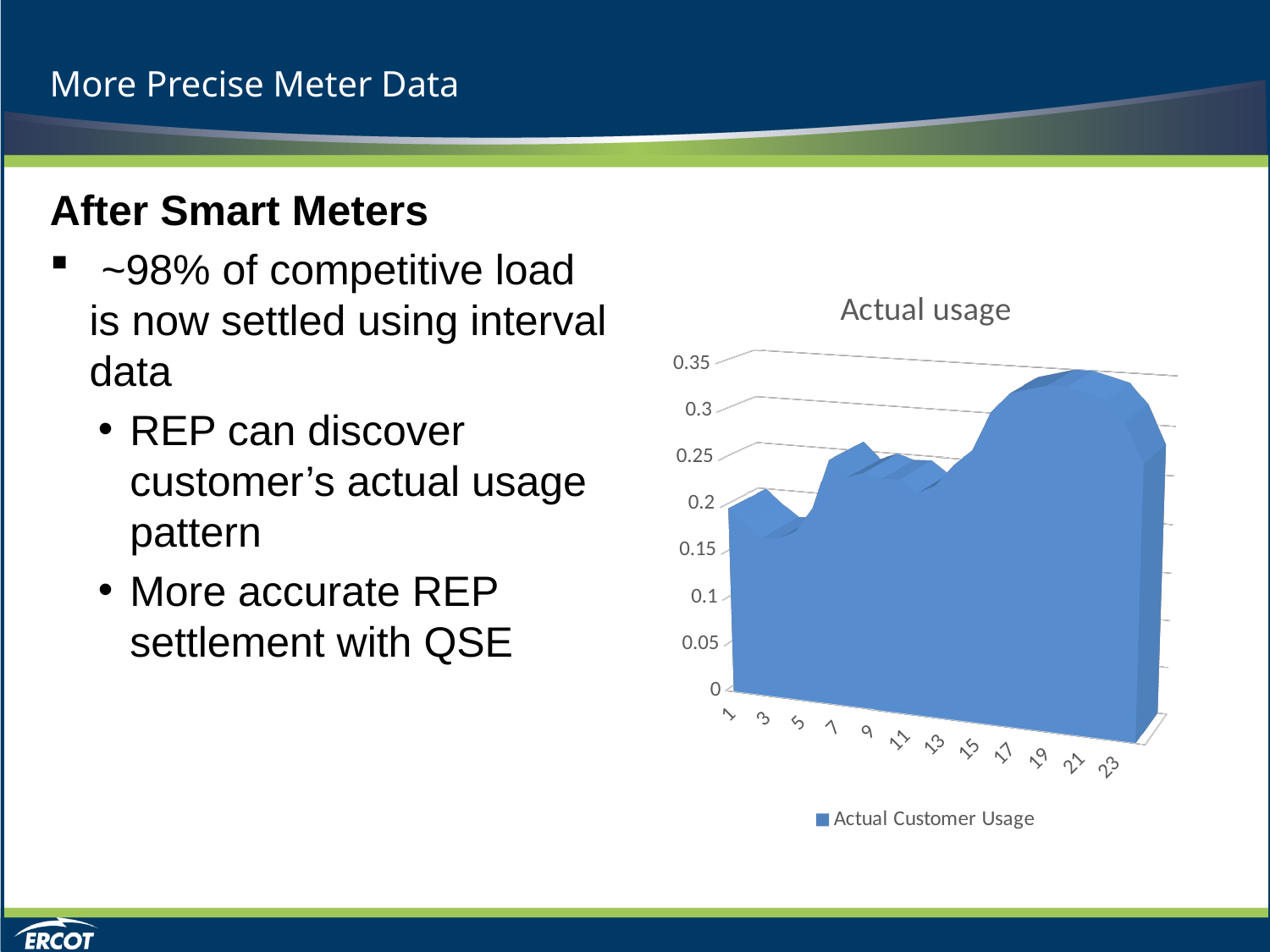
What is the name of the series shown in the chart legend? Actual Customer Usage Which has the larger value, category 7 or category 3? 7 Is the value for category 3 greater or less than 0.25? less What kind of chart is shown on the slide? area chart What is the title of the chart? Actual usage What is the highest value shown on the chart's vertical axis? 0.35 What is the last category label shown on the chart's horizontal axis? 23 Which has the larger value, category 19 or category 5? 19 How many series does the chart legend list? 1 Do the values rise or fall along the x axis from category 13 to category 19? rise Is the value for category 1 greater or less than 0.3? less Is the value for category 21 greater or less than 0.3? greater